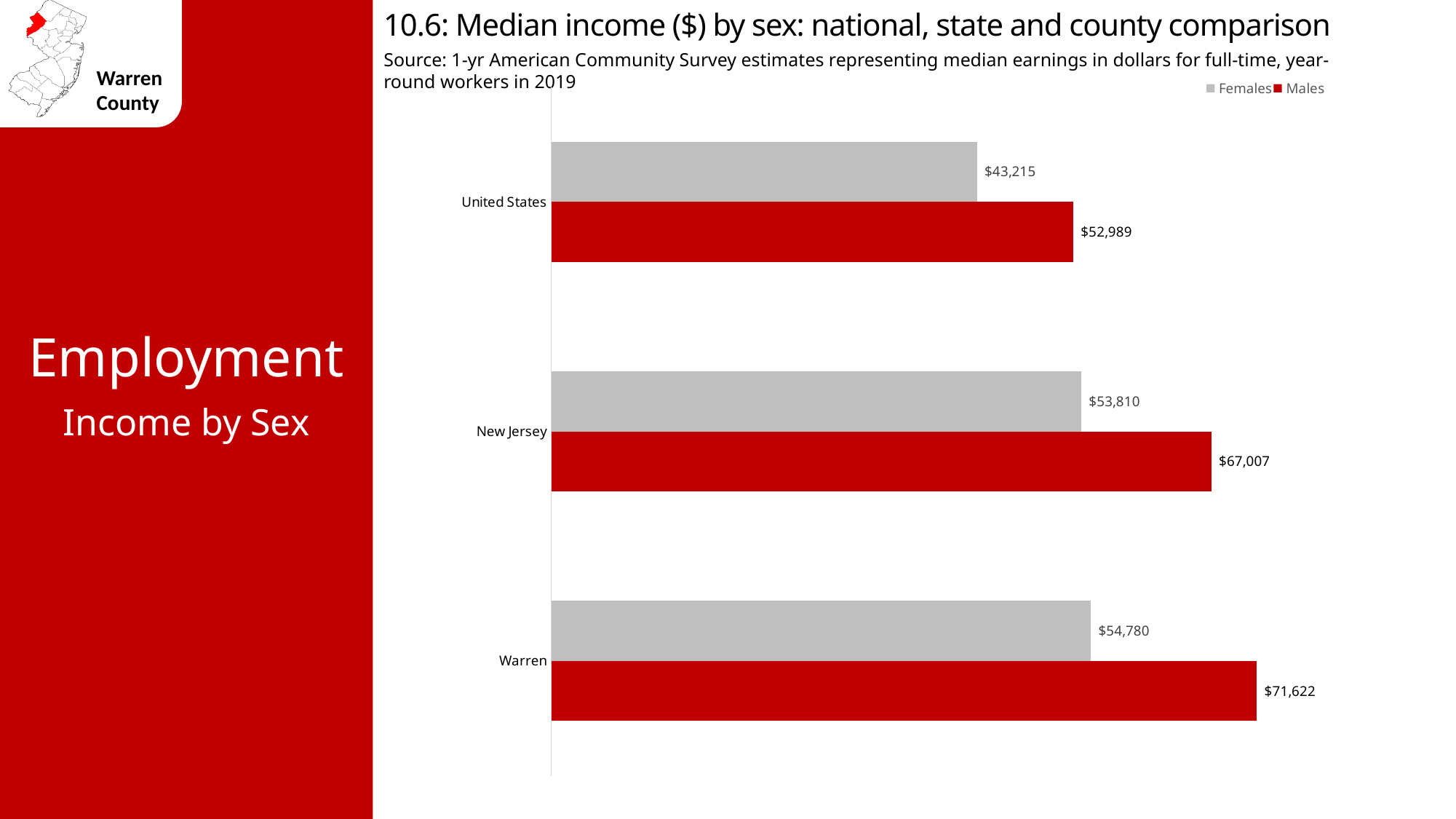
What is the difference between male median income in New Jersey and in the United States? $14,018 How many geographies are shown on the chart? 3 What is the median income for females in the United States? $43,215 Which geography has the lowest median income for females? United States What is the median income for males in Warren? $71,622 What is the difference between male and female median income in Warren? $16,842 What is the median income for females in Warren? $54,780 How many series does the legend list? 2 Which geography has the highest median income for males? Warren What is the median income for males in New Jersey? $67,007 What kind of chart is shown on the slide? Bar chart Which is larger: female median income in New Jersey or male median income in the United States? Female median income in New Jersey